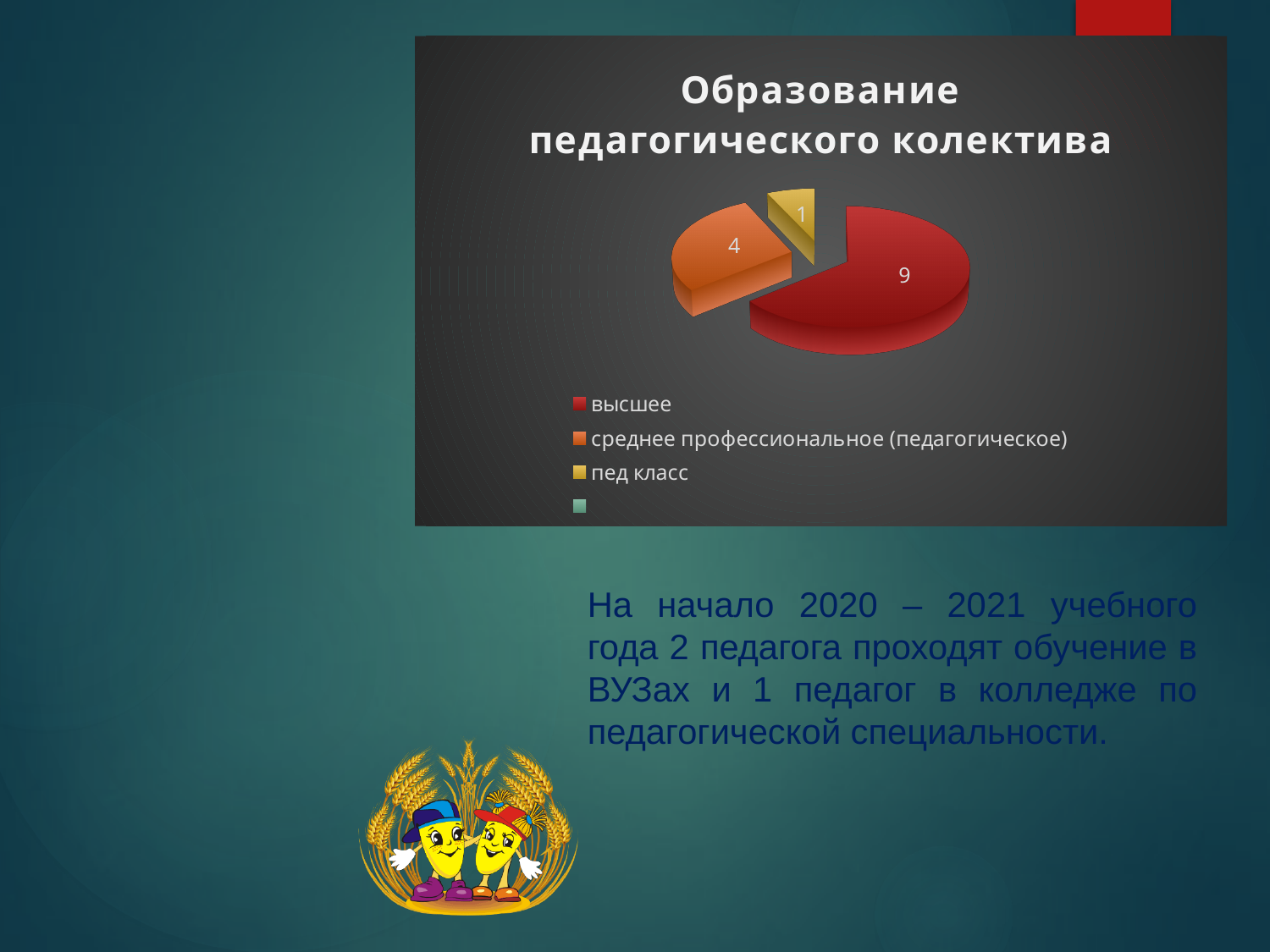
Which is larger, the "высшее" slice or the "среднее профессиональное (педагогическое)" slice? высшее How many labelled slices does the pie chart have? 3 Which category has the largest slice? высшее What type of chart is shown on the slide? pie chart Which category has the smallest slice? пед класс What is the value for the "пед класс" slice? 1 What is the difference between the "среднее профессиональное (педагогическое)" and "пед класс" values? 3 What is the difference between the "высшее" and "среднее профессиональное (педагогическое)" values? 5 What is the title of the chart? Образование педагогического колектива What is the total of all the slice values in the pie chart? 14 What is the value for the "высшее" slice? 9 What is the value for the "среднее профессиональное (педагогическое)" slice? 4